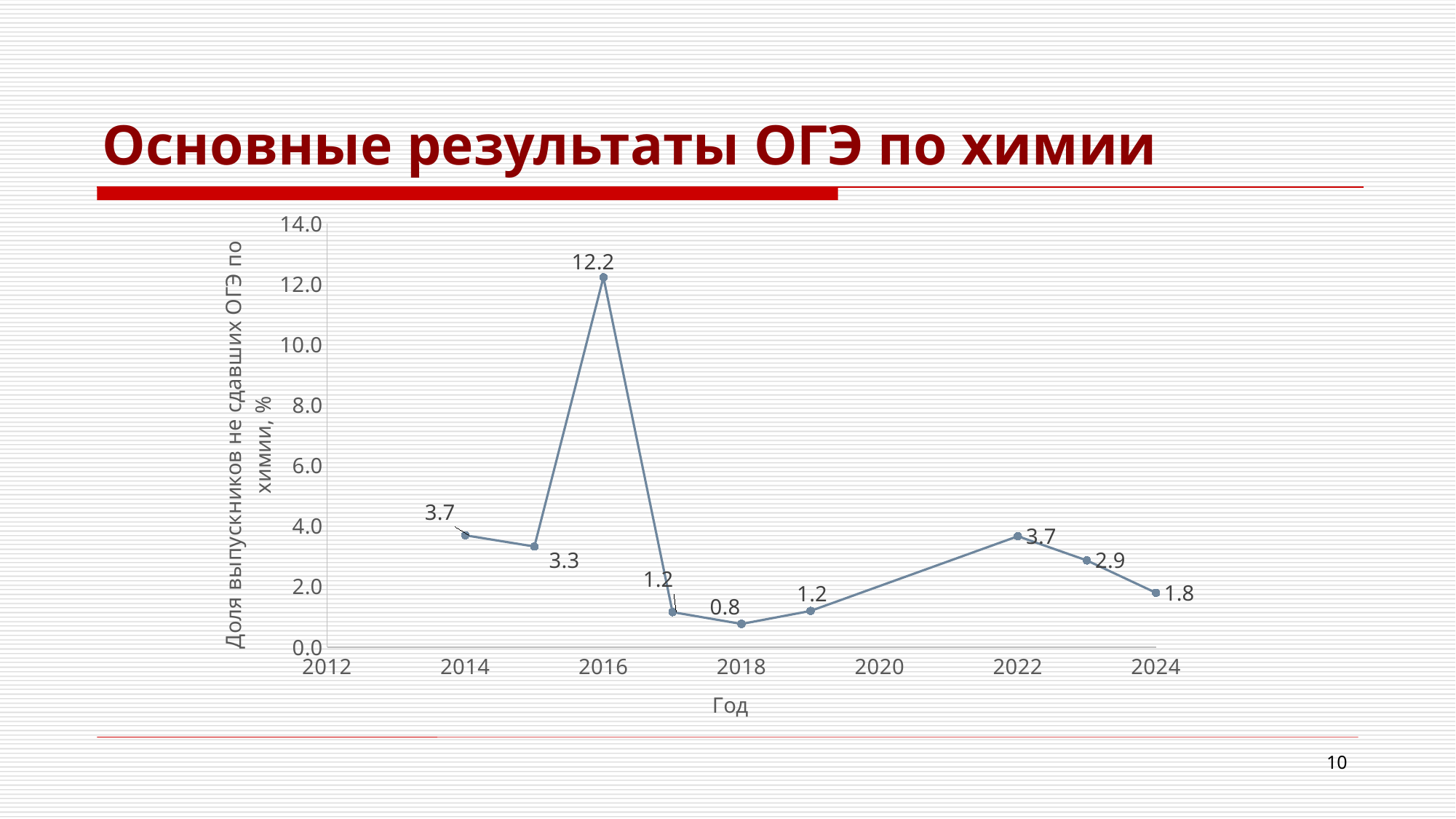
What is the value for 2016? 12.2 Which year has the lowest value? 2018 What is the value for 2022? 3.7 How many data points are plotted on the line? 9 What is the difference between the values for 2016 and 2014? 8.5 What is the value for 2024? 1.8 What kind of chart is shown on the slide? line chart What is the value for 2018? 0.8 What is the label of the x axis? Год Is the value for 2016 greater or less than 10.0? greater Which year has the highest value? 2016 Which is larger, the value for 2022 or the value for 2024? 2022